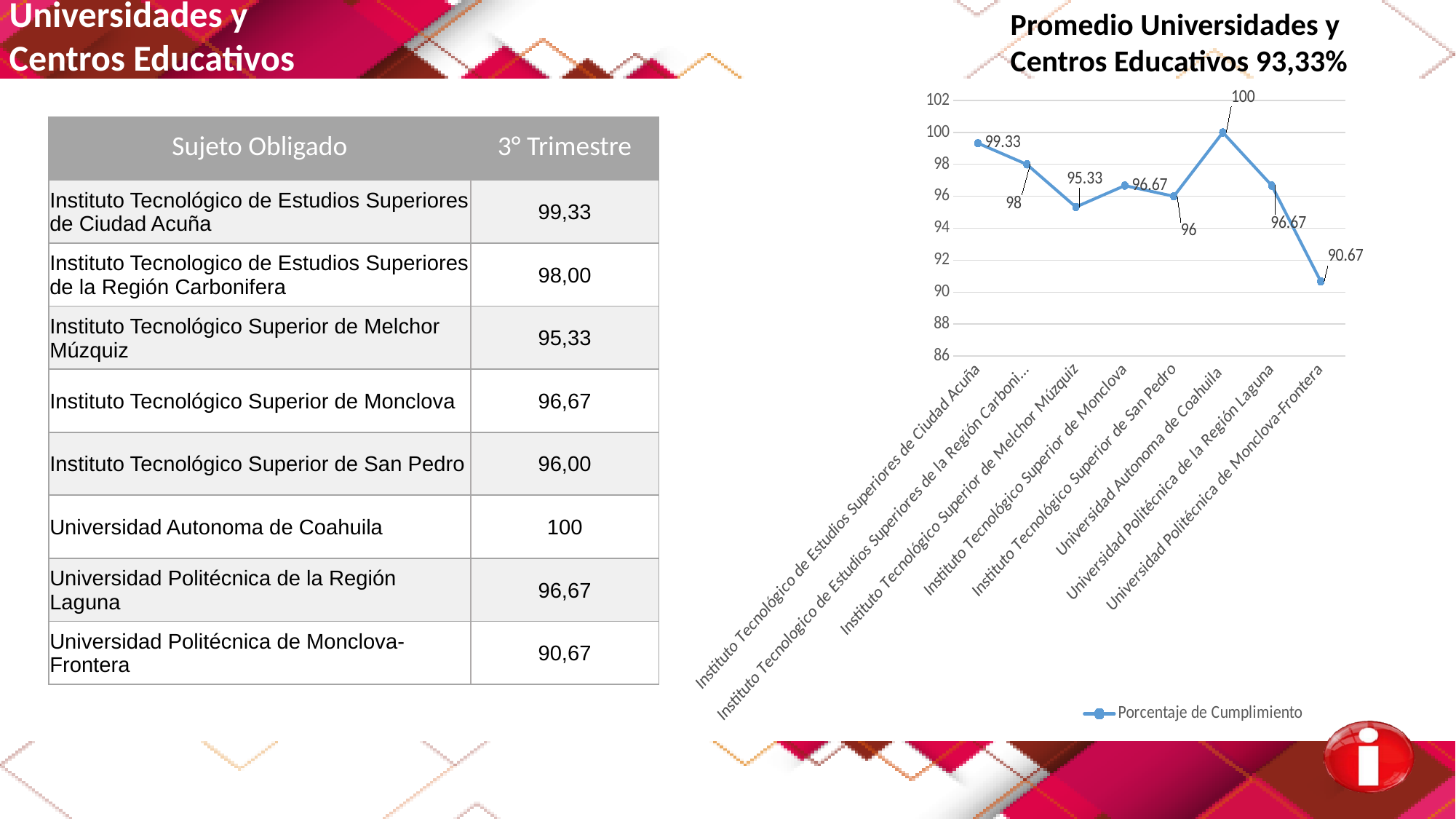
How many series does the chart legend list? 1 What is the difference between the values for Universidad Autonoma de Coahuila and Universidad Politécnica de Monclova-Frontera? 9.33 Which category has the highest value in the chart? Universidad Autonoma de Coahuila Which is larger: the value for Instituto Tecnológico Superior de Monclova or the value for Instituto Tecnológico Superior de San Pedro? Instituto Tecnológico Superior de Monclova What type of chart is shown on the slide? line chart What is the name of the series shown in the chart legend? Porcentaje de Cumplimiento What is the value for Universidad Politécnica de Monclova-Frontera in the chart? 90.67 Which category has the lowest value in the chart? Universidad Politécnica de Monclova-Frontera What is the value for Instituto Tecnológico Superior de Melchor Múzquiz in the chart? 95.33 What is the value for Universidad Autonoma de Coahuila in the chart? 100 Is the value for Universidad Politécnica de Monclova-Frontera greater or less than 92? less How many categories are plotted on the x axis of the chart? 8